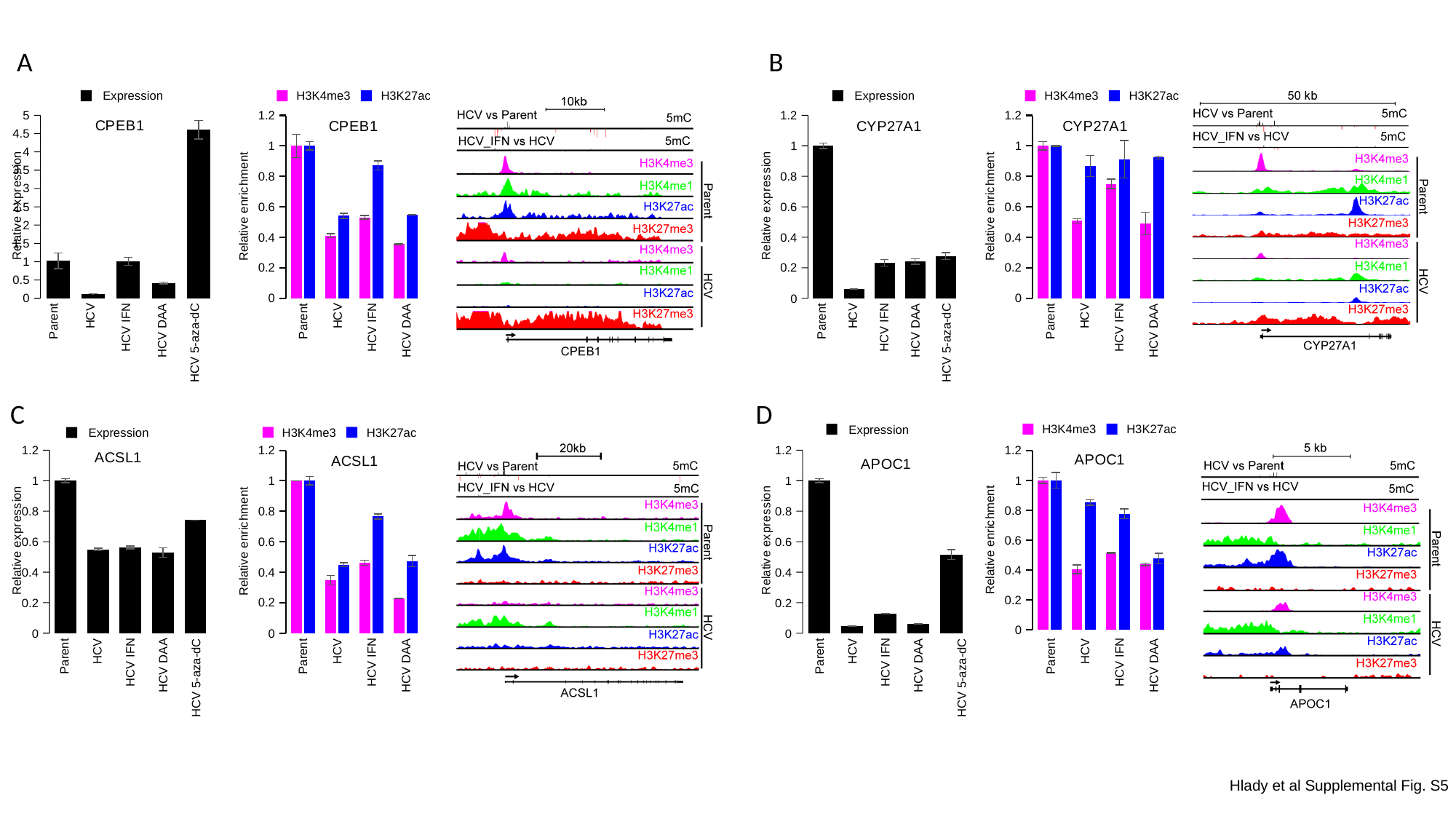
In the CPEB1 expression chart in panel A, which category has the highest relative expression? HCV 5-aza-dC In the CPEB1 expression chart in panel A, which category has the lowest relative expression? HCV In the APOC1 relative enrichment chart in panel D, which is larger for HCV, H3K4me3 or H3K27ac? H3K27ac In the CYP27A1 relative enrichment chart in panel B, which is larger for HCV DAA, H3K4me3 or H3K27ac? H3K27ac In the CPEB1 expression chart in panel A, is the value for HCV 5-aza-dC greater or less than 4? greater What kind of chart is the APOC1 expression chart in panel D? bar chart How many categories are shown on the x axis of the CPEB1 expression chart in panel A? 5 In the ACSL1 expression chart in panel C, is the value for HCV 5-aza-dC greater or less than 0.6? greater How many series does the legend list for the CPEB1 relative enrichment chart in panel A? 2 In the CYP27A1 expression chart in panel B, which category has the lowest relative expression? HCV In the CPEB1 relative enrichment chart in panel A, is the H3K27ac value for HCV IFN greater or less than 0.8? greater